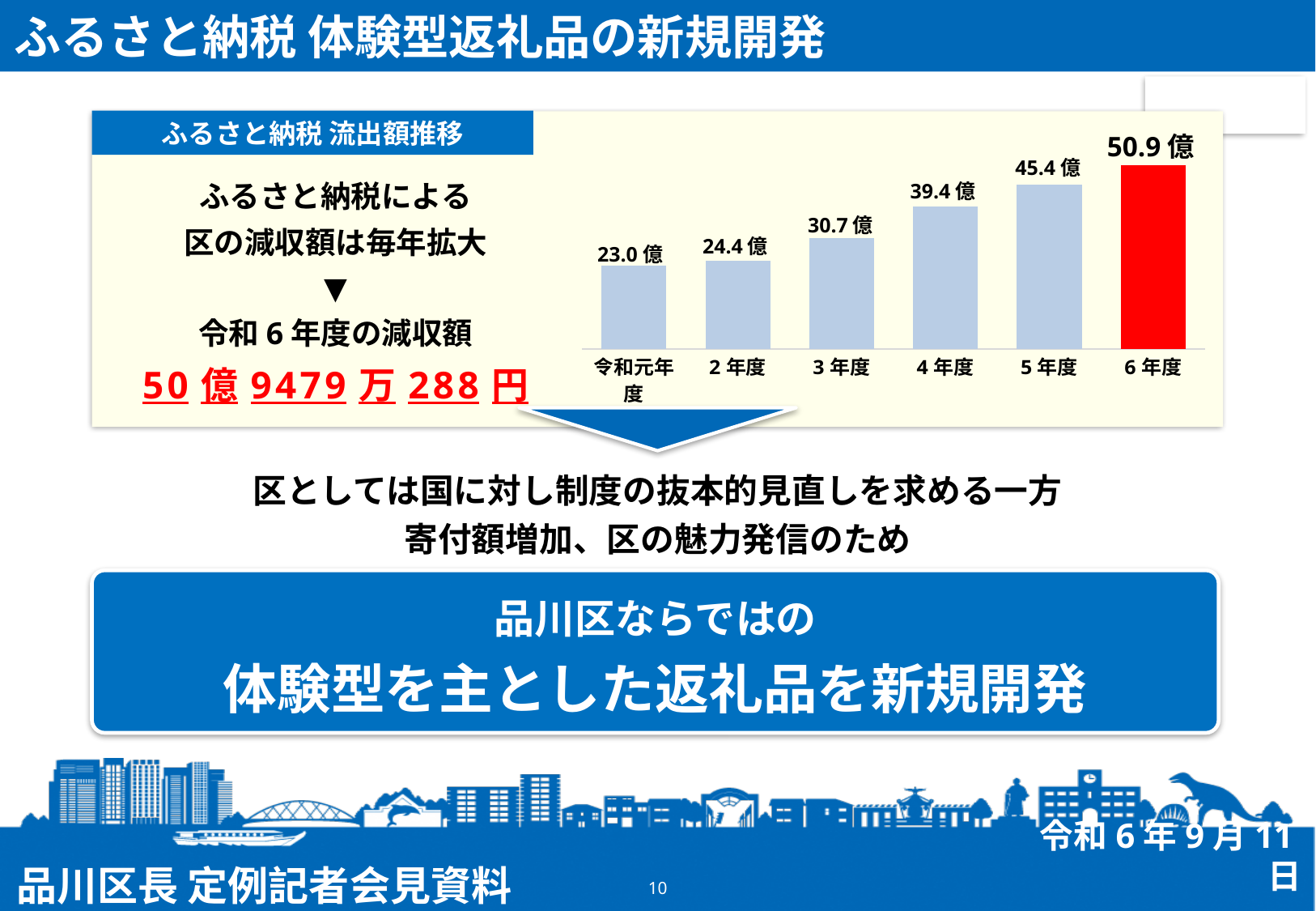
Which fiscal year has the highest value in the chart? 6 年度 Do the values rise or fall from 令和元年度 to 6 年度? Rise What is the difference between the values for 6 年度 and 5 年度? 5.5 億 What is the value shown for 令和元年度 in the ふるさと納税 流出額推移 chart? 23.0 億 Which bar in the chart is coloured red? 6 年度 Which fiscal year has the lowest value in the chart? 令和元年度 What kind of chart is used to show the ふるさと納税 流出額推移? Bar chart What is the value shown for 5 年度 in the chart? 45.4 億 How many fiscal years (bars) are shown in the chart? 6 What is the difference between the values for 4 年度 and 令和元年度? 16.4 億 Which is larger, the value for 2 年度 or the value for 3 年度? 3 年度 What is the value shown for 3 年度 in the chart? 30.7 億